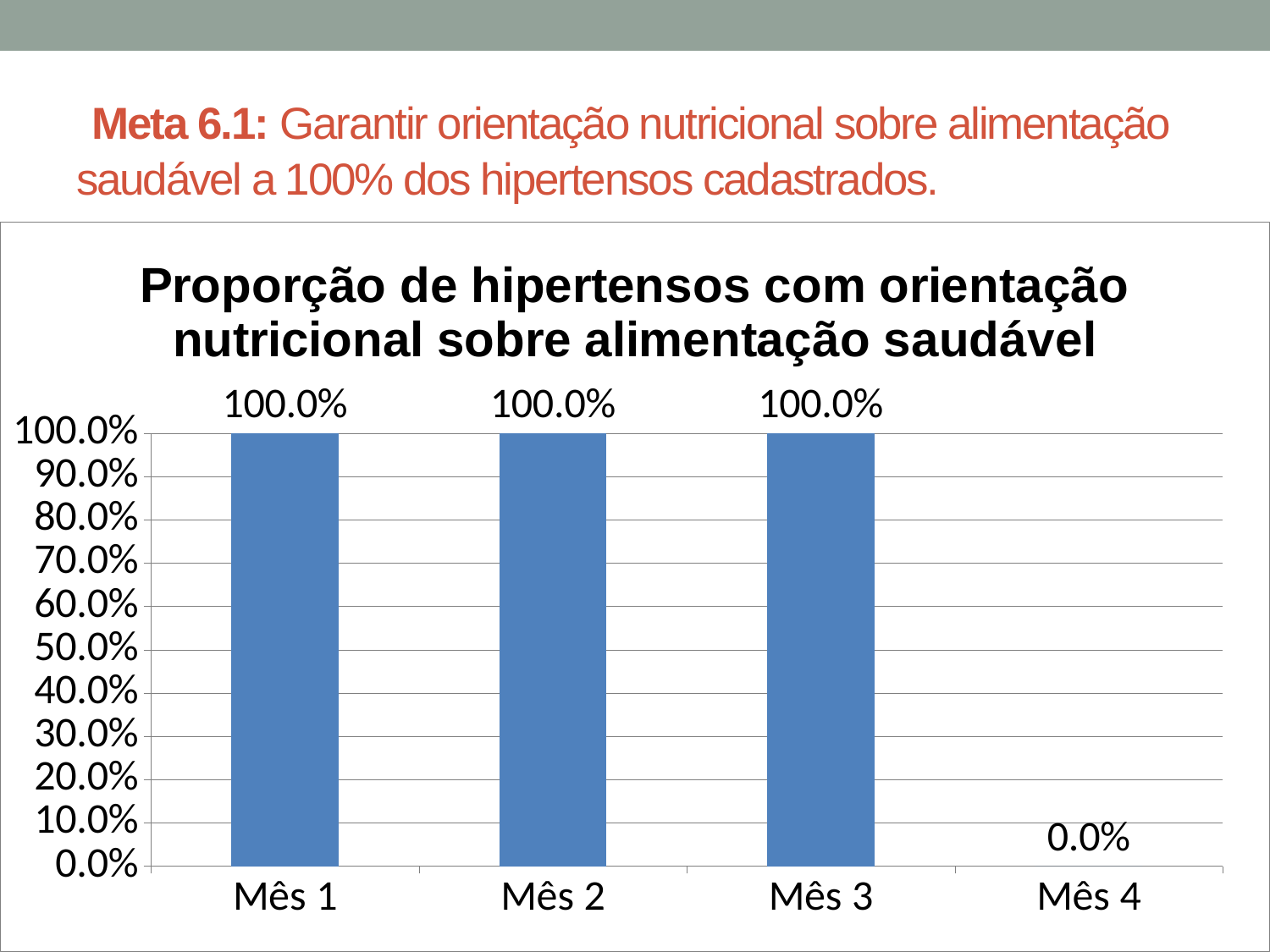
What colour are the bars in the chart? blue What is the value for Mês 3? 100.0% Which category has the lowest value? Mês 4 What is the value for Mês 4? 0.0% Do the values stay the same or change from Mês 1 to Mês 3? stay the same What is the value for Mês 1? 100.0% Which is larger, the value for Mês 3 or the value for Mês 4? Mês 3 What is the difference between the values for Mês 2 and Mês 4? 100.0% How many categories are shown on the x axis? 4 What kind of chart is shown on the slide? bar chart Is the value for Mês 2 greater or less than 50.0%? greater What is the title of the chart? Proporção de hipertensos com orientação nutricional sobre alimentação saudável